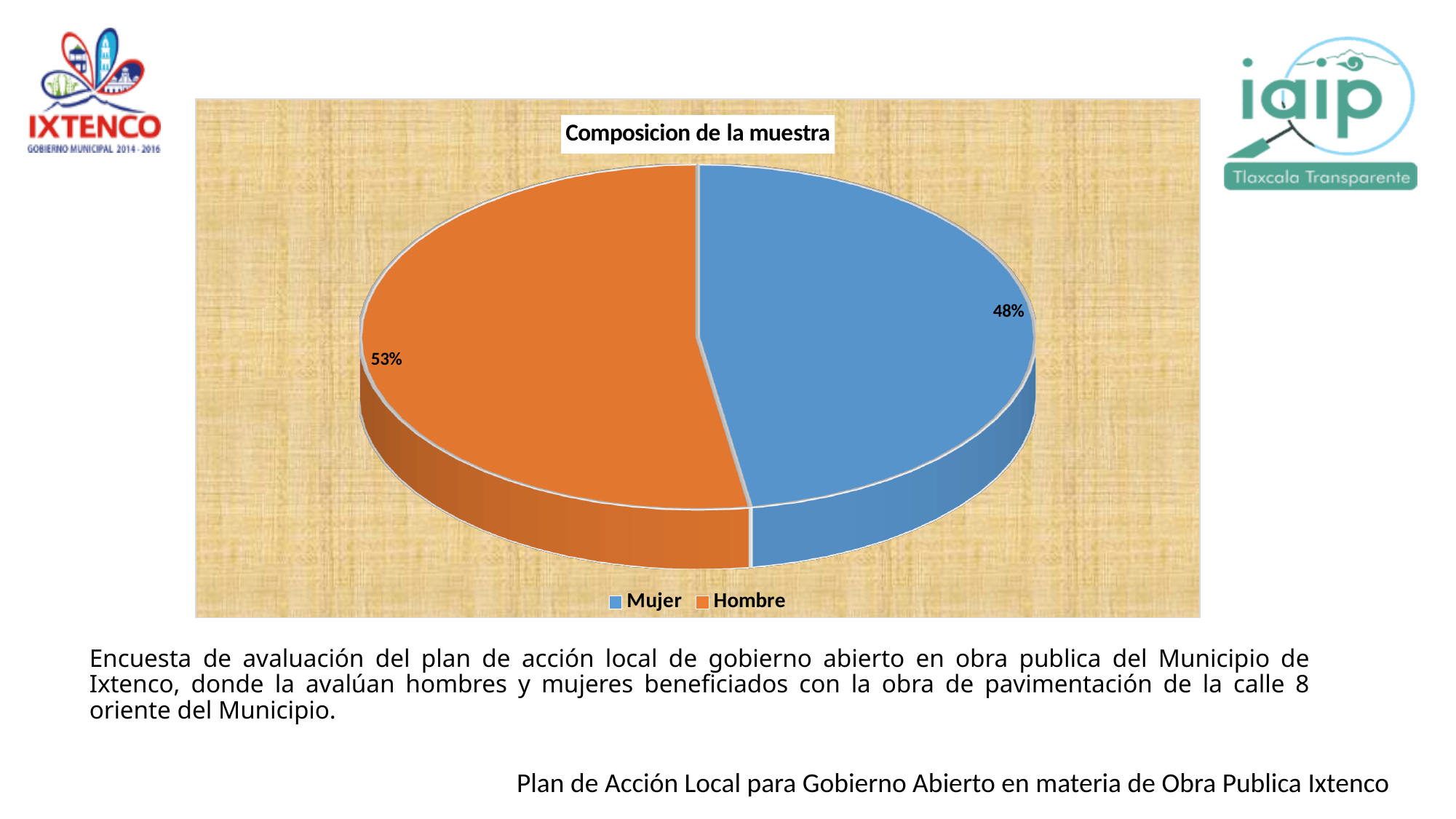
What is the title of the chart? Composicion de la muestra How many entries does the legend list? 2 What percentage of the sample is Hombre? 53% What is the difference in percentage points between the Hombre and Mujer shares? 5% What type of chart is shown on the slide? Pie chart Is the share for Hombre larger or smaller than the share for Mujer? Larger Is the share for Mujer greater or less than 50%? less What percentage of the sample is Mujer? 48% How many slices does the pie chart have? 2 Which category has the smaller share of the pie? Mujer Which colour represents Mujer in the chart? Blue Which category has the larger share of the pie? Hombre